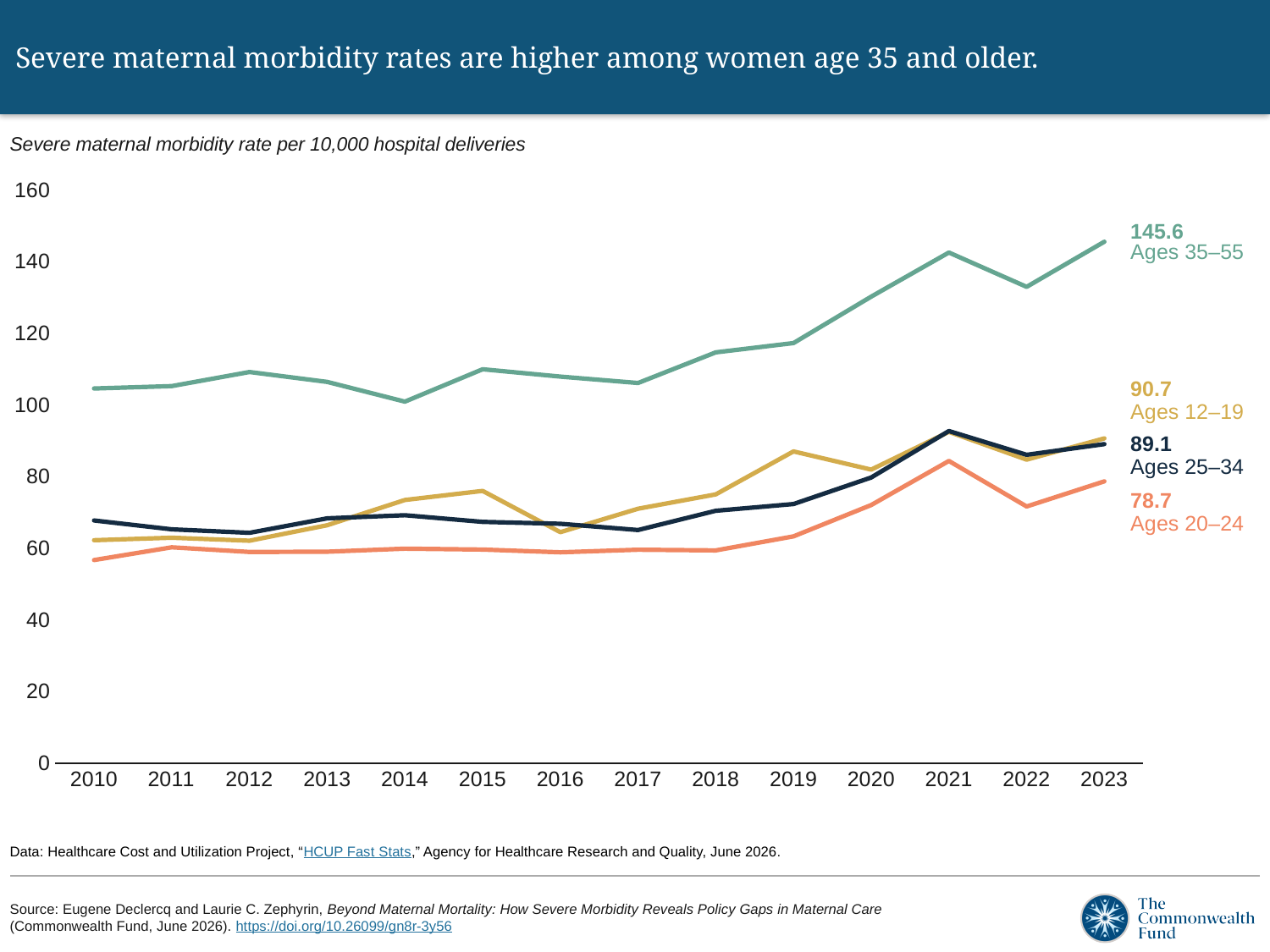
Is the rate for Ages 35–55 in 2010 greater or less than 100? greater What type of chart is shown on the slide? Line chart What is the difference between the 2023 rates for Ages 35–55 and Ages 20–24? 66.9 Which age group has the highest severe maternal morbidity rate in 2023? Ages 35–55 Is the rate for Ages 20–24 in 2010 greater or less than 60? less In 2023, which has the higher rate: Ages 12–19 or Ages 25–34? Ages 12–19 How many age-group series are plotted on the chart? 4 Which age group has the lowest severe maternal morbidity rate in 2023? Ages 20–24 What is the severe maternal morbidity rate for Ages 20–24 in 2023? 78.7 What is the severe maternal morbidity rate for Ages 12–19 in 2023? 90.7 What is the severe maternal morbidity rate for Ages 35–55 in 2023? 145.6 How many years are shown on the x axis? 14